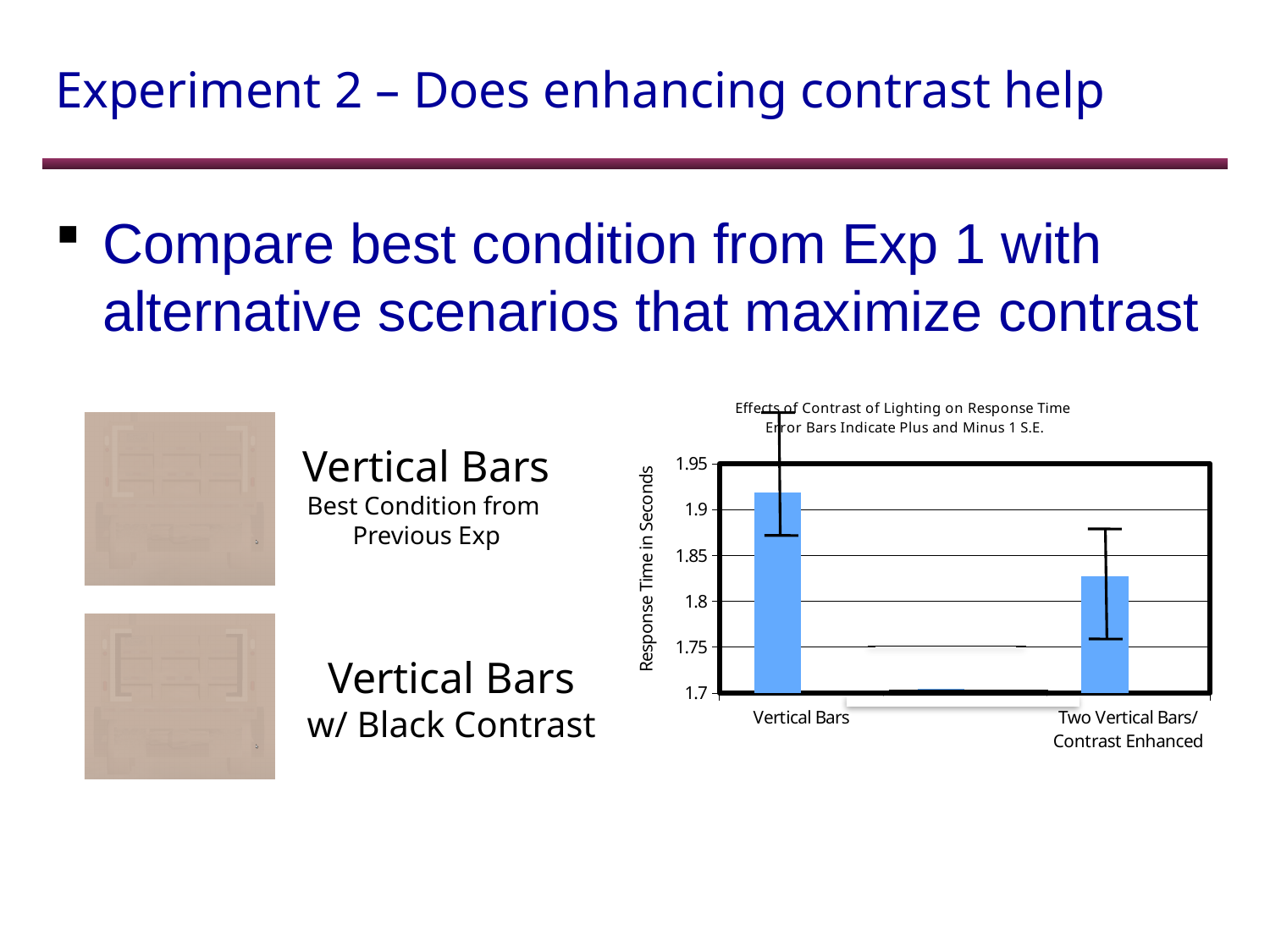
Is the value for Two Vertical Bars/ Contrast Enhanced greater or less than 1.9? less What kind of chart is shown on the slide? Bar chart According to the chart title, what do the error bars indicate? Plus and Minus 1 S.E. Is the value for Two Vertical Bars/ Contrast Enhanced greater or less than 1.8? greater Which category has the lowest response time in the chart? Two Vertical Bars/ Contrast Enhanced Is the value for Vertical Bars greater or less than 1.85? greater Do the bar values rise or fall from left to right along the x axis? fall How many categories are plotted on the x axis of the chart? 2 What is the label of the y axis of the chart? Response Time in Seconds Which has the larger response time: Vertical Bars or Two Vertical Bars/ Contrast Enhanced? Vertical Bars Which category has the highest response time in the chart? Vertical Bars